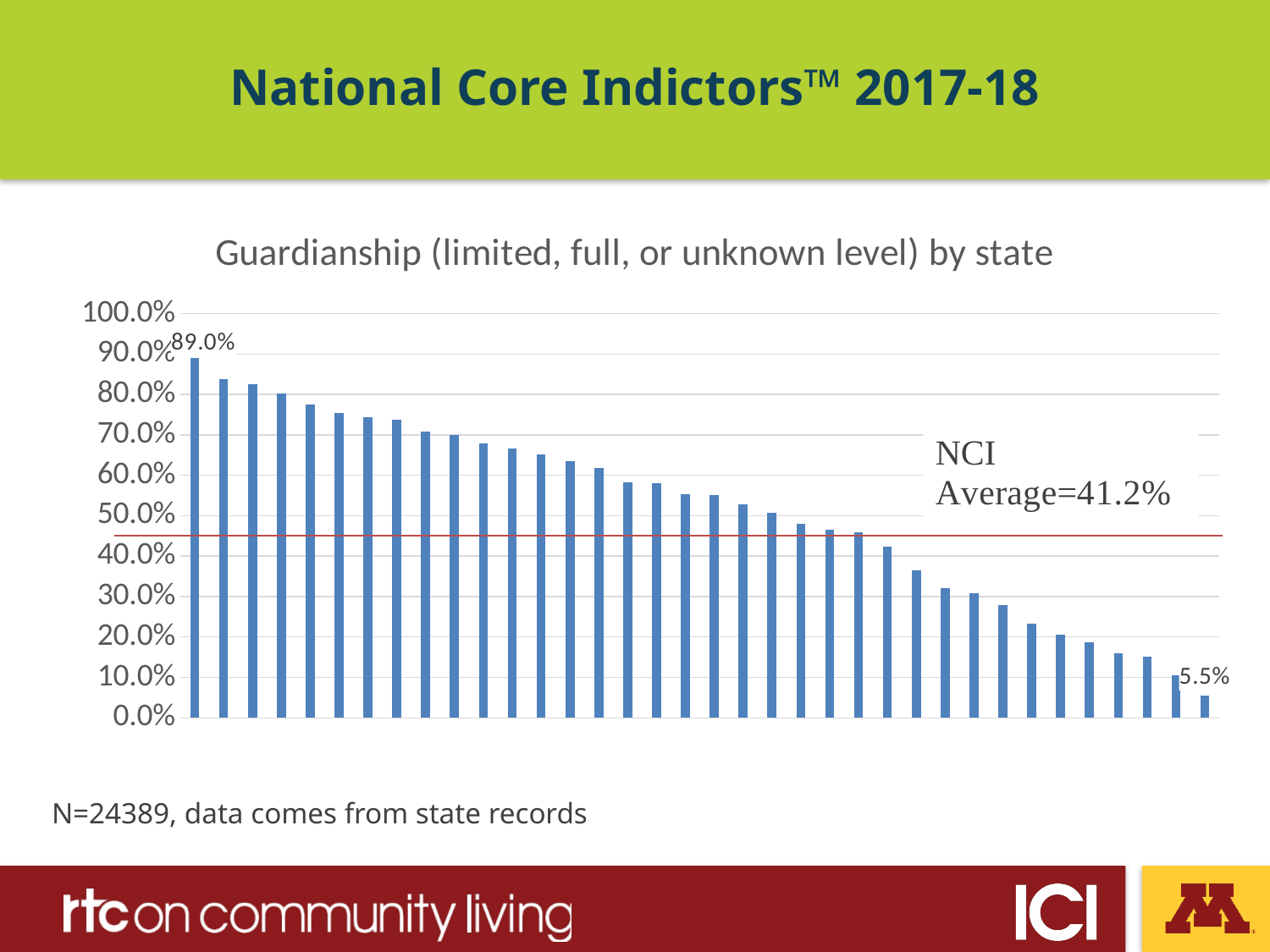
What is the value shown on the tallest (leftmost) bar in the chart? 89.0% What is the difference between the highest labeled value (89.0%) and the lowest labeled value (5.5%) in the chart? 83.5% Do the bar values rise or fall moving from left to right across the chart? Fall What type of chart is shown on the slide? Bar chart Is the value of the leftmost bar greater or less than 80%? greater What is the value shown on the shortest (rightmost) bar in the chart? 5.5% Which is larger, the value of the leftmost bar or the value of the rightmost bar? The leftmost bar What does the horizontal red line across the chart represent? NCI Average=41.2% What is the title of the chart? Guardianship (limited, full, or unknown level) by state Is the value of the rightmost bar greater or less than 10%? less Is the value of the second bar from the left greater or less than 80%? greater What is the NCI Average value shown on the chart? 41.2%